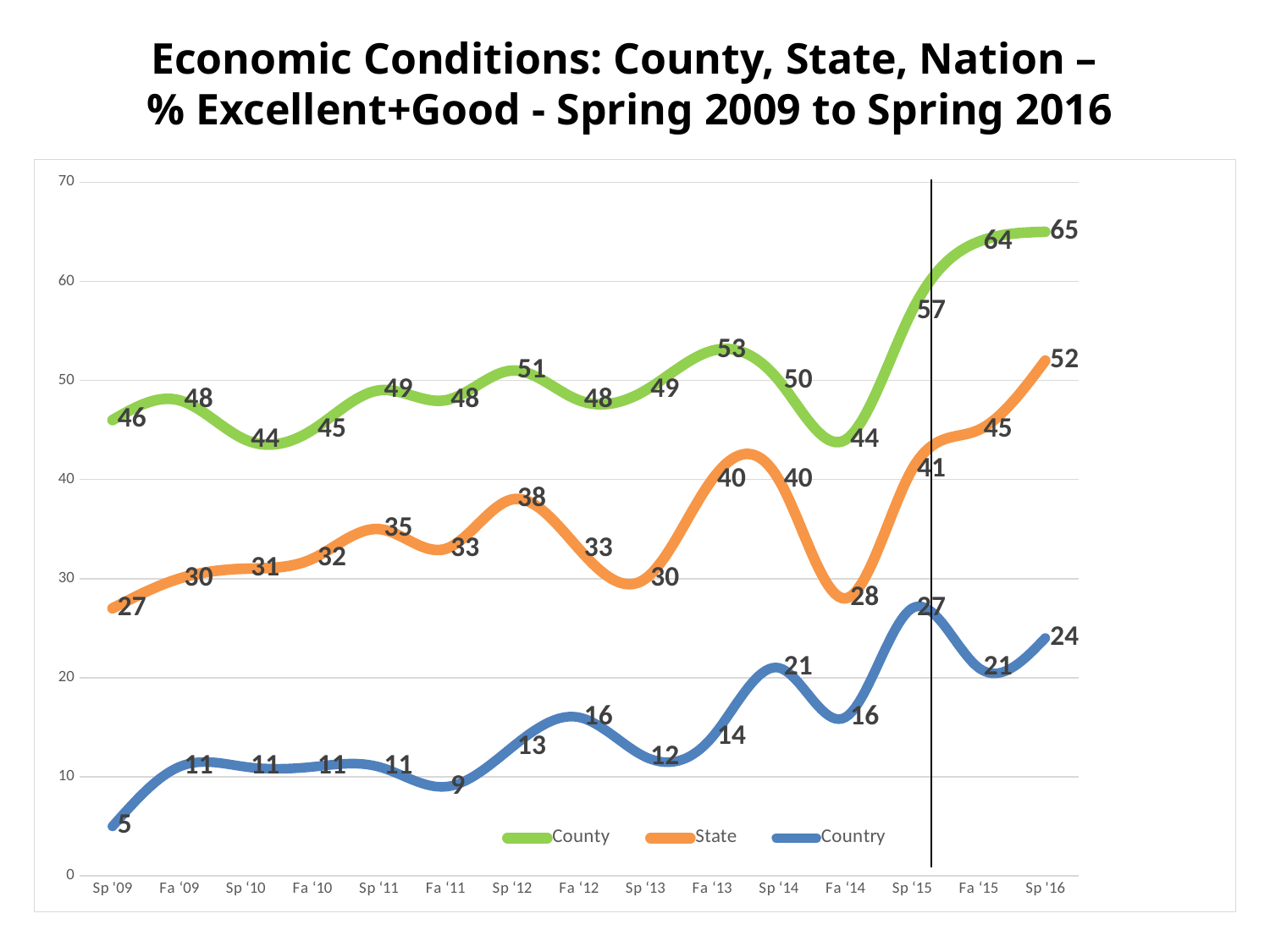
What type of chart is shown on the slide? Line chart Which is larger at Fa '13: the State value or the Country value? State At which point is the State series lowest? Sp '09 How many series does the legend list? 3 What is the Country value for Sp '09? 5 What is the difference between the County and State values at Sp '16? 13 At which point does the Country series reach its highest value? Sp '15 How many time points are plotted along the x axis? 15 Which series is drawn in orange? State What is the County value for Sp '16? 65 Does the County series rise or fall from Sp '15 to Sp '16? Rise What is the State value for Fa '14? 28